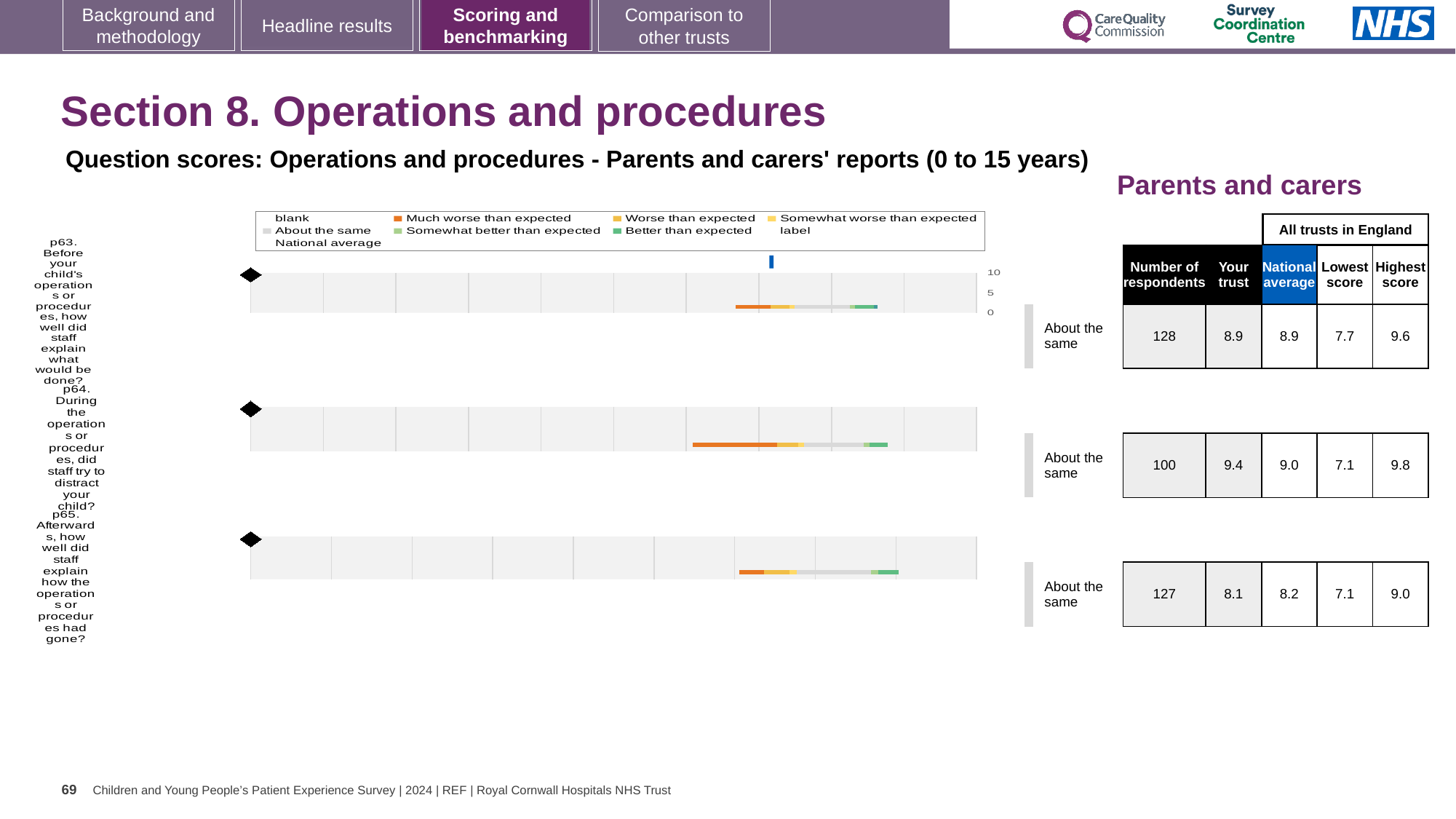
What benchmark category is shown for all three questions on this slide? About the same What is the 'Your trust' score for p63 (Before your child's operations or procedures, how well did staff explain what would be done?)? 8.9 Which question has the highest 'Your trust' score? p64 What kind of chart is used to show the question scores on this slide? bar chart What is the national average score for p64 (During the operations or procedures, did staff try to distract your child?)? 9.0 Which question has the lowest 'Your trust' score? p65 Is the 'Your trust' score for p63 greater or less than 5? greater How many respondents answered p64? 100 For p65, which is larger: the 'Your trust' score or the national average? national average How many questions (chart rows) are shown on the slide? 3 What is the difference between the 'Your trust' score and the national average for p64? 0.4 What is the highest score across all trusts in England for p65 (Afterwards, how well did staff explain how the operations or procedures had gone?)? 9.0